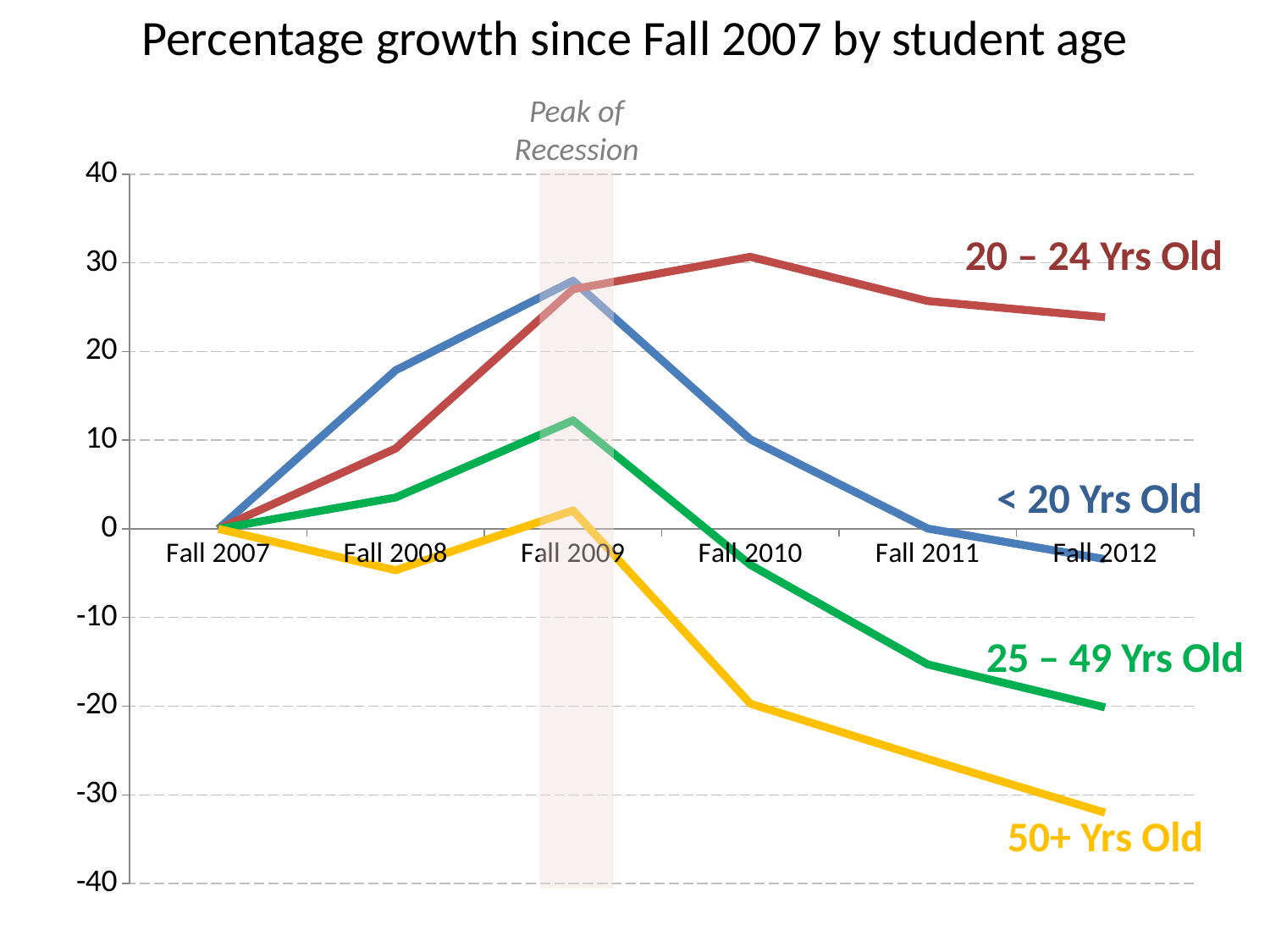
Does the 50+ Yrs Old series rise or fall from Fall 2009 to Fall 2012? fall What kind of chart is shown on the slide? line chart What does the shaded vertical band around Fall 2009 represent? Peak of Recession Which age group has the lowest value at Fall 2012? 50+ Yrs Old At Fall 2011, which is larger: the value for 25 – 49 Yrs Old or the value for 50+ Yrs Old? 25 – 49 Yrs Old What is the value for the 20 – 24 Yrs Old series at Fall 2007? 0 Is the value for the 20 – 24 Yrs Old series at Fall 2012 greater or less than 20? greater Which age group has the highest value at Fall 2008? < 20 Yrs Old Is the value for the 50+ Yrs Old series at Fall 2012 greater or less than -30? less How many time points are shown on the x axis? 6 How many age-group series are plotted on the chart? 4 Which age group has the highest value at Fall 2012? 20 – 24 Yrs Old